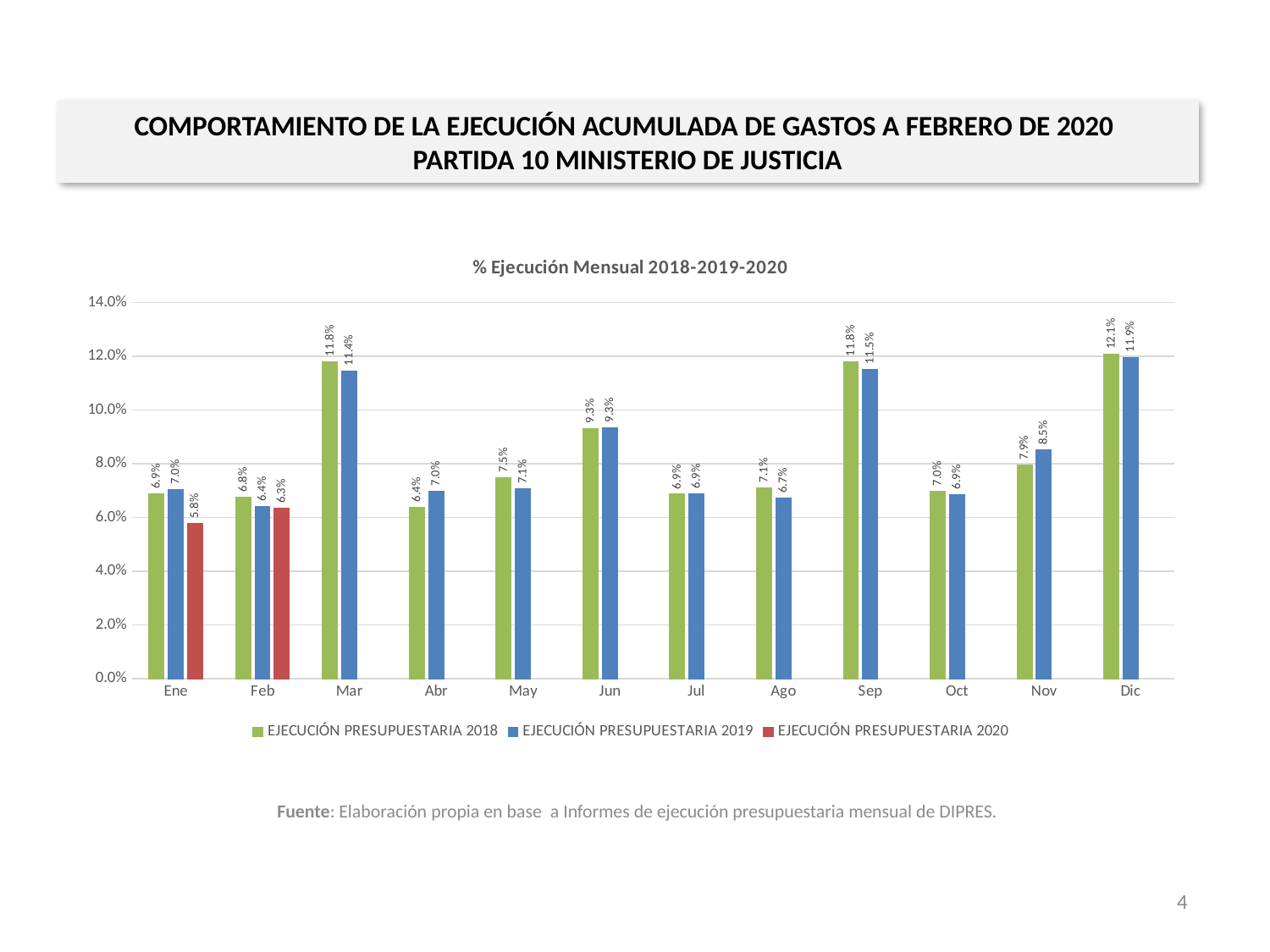
What is the title of the chart? % Ejecución Mensual 2018-2019-2020 In which month is the EJECUCIÓN PRESUPUESTARIA 2018 value lowest? Abr What is the value for EJECUCIÓN PRESUPUESTARIA 2018 in Sep? 11.8% How many months are shown on the x axis? 12 In Nov, which series has the larger value: EJECUCIÓN PRESUPUESTARIA 2018 or EJECUCIÓN PRESUPUESTARIA 2019? EJECUCIÓN PRESUPUESTARIA 2019 What kind of chart is shown on the slide? bar chart Is the value for EJECUCIÓN PRESUPUESTARIA 2019 in Mar greater or less than 10.0%? greater How many series does the legend list? 3 What is the value for EJECUCIÓN PRESUPUESTARIA 2019 in Nov? 8.5% What is the difference between the EJECUCIÓN PRESUPUESTARIA 2018 and EJECUCIÓN PRESUPUESTARIA 2020 values in Feb? 0.5% In which month is the EJECUCIÓN PRESUPUESTARIA 2018 value highest? Dic What is the value for EJECUCIÓN PRESUPUESTARIA 2020 in Ene? 5.8%